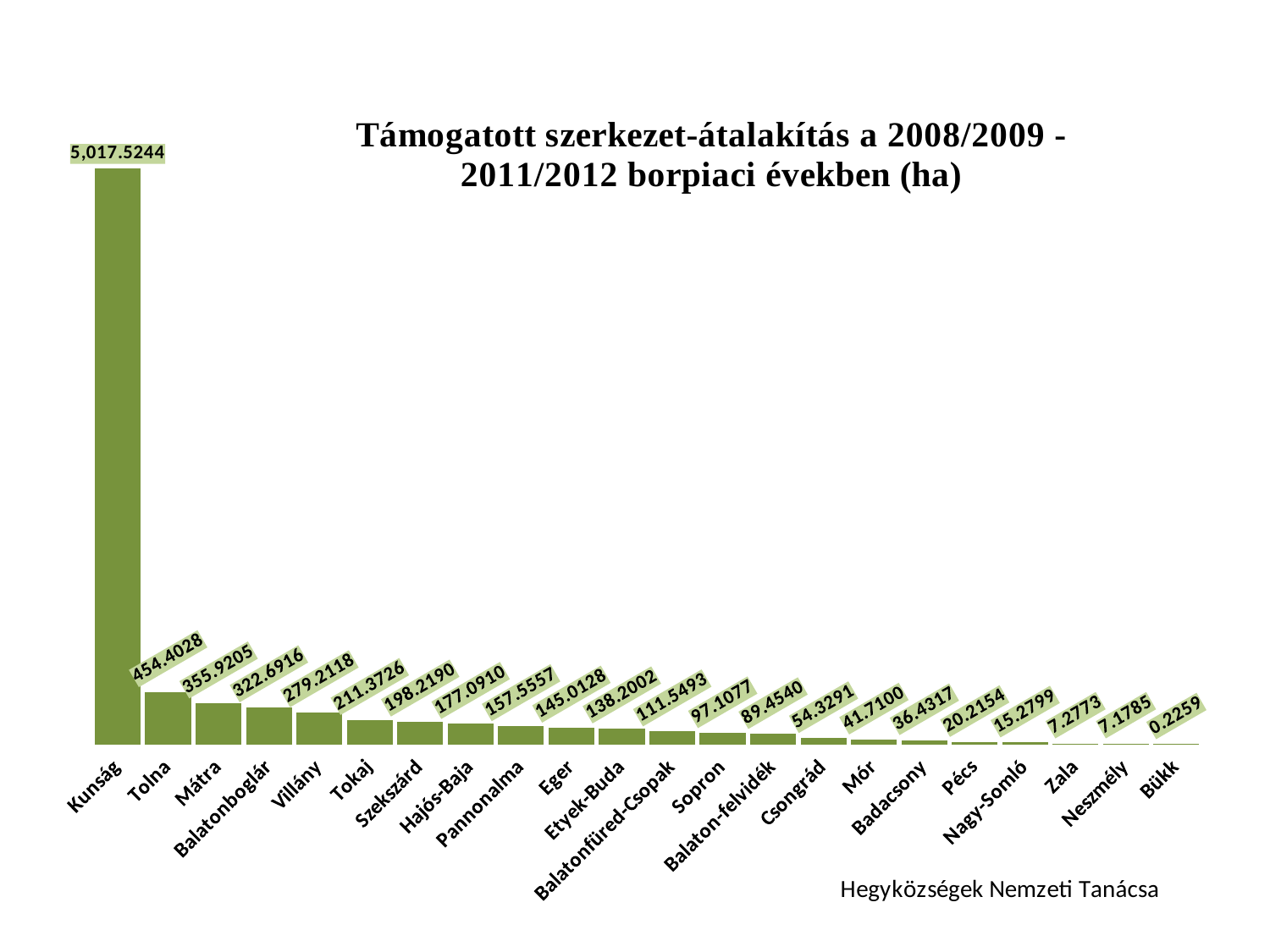
Which category has the highest value? Kunság Which category has the lowest value? Bükk What kind of chart is shown on the slide? Bar chart What is the value for Szekszárd? 198.2190 What is the value for Kunság? 5,017.5244 What is the value for Balatonfüred-Csopak? 111.5493 Do the values rise or fall from left to right along the x axis? Fall Which is larger, the value for Villány or the value for Tokaj? Villány How many categories are shown on the x axis? 22 What is the value for Tolna? 454.4028 What is the difference between the values for Eger and Etyek-Buda? 6.8126 What is the difference between the values for Tolna and Mátra? 98.4823